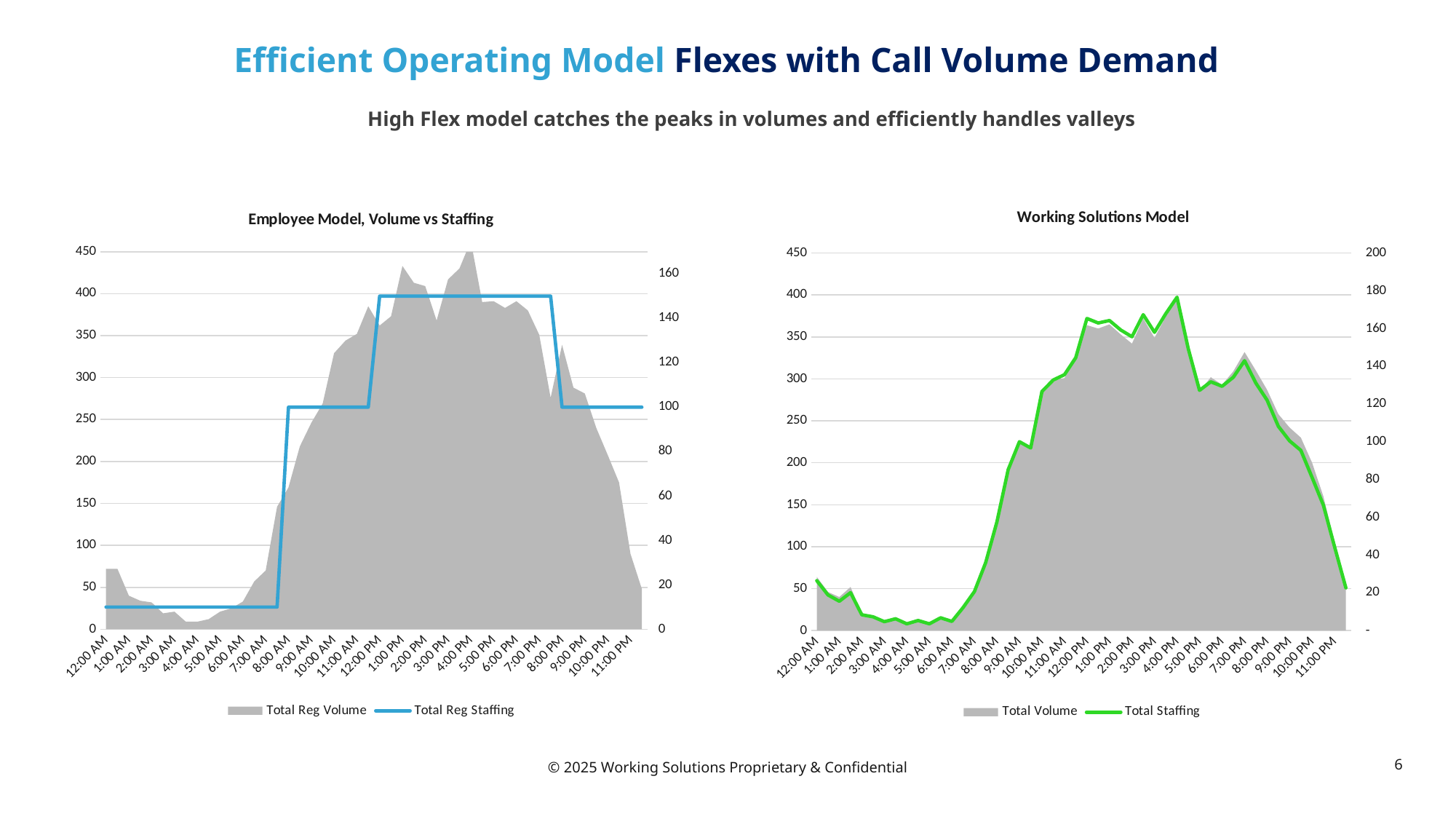
On the Working Solutions Model chart, does Total Staffing rise or fall from 7:00 PM to 11:00 PM? fall How many time points are shown along the x axis of the Working Solutions Model chart? 24 On the Employee Model, Volume vs Staffing chart, which is larger: the Total Reg Volume at 2:00 PM or at 9:00 PM? 2:00 PM On the Working Solutions Model chart, is the Total Staffing value at 4:00 PM greater or less than 160 on the right-hand axis? greater How many series does the legend of the Employee Model, Volume vs Staffing chart list? 2 What are the two legend entries on the Working Solutions Model chart? Total Volume and Total Staffing On the Employee Model, Volume vs Staffing chart, what is the Total Reg Staffing value at 10:00 PM on the right-hand axis? 100 On the Employee Model, Volume vs Staffing chart, is the Total Reg Volume at 4:00 PM greater or less than 400? greater On the Working Solutions Model chart, at which hour does Total Staffing reach its highest value? 4:00 PM On the Employee Model, Volume vs Staffing chart, is the Total Reg Volume at 4:00 AM greater or less than 50? less On the Employee Model, Volume vs Staffing chart, what is the Total Reg Staffing value at 9:00 AM on the right-hand axis? 100